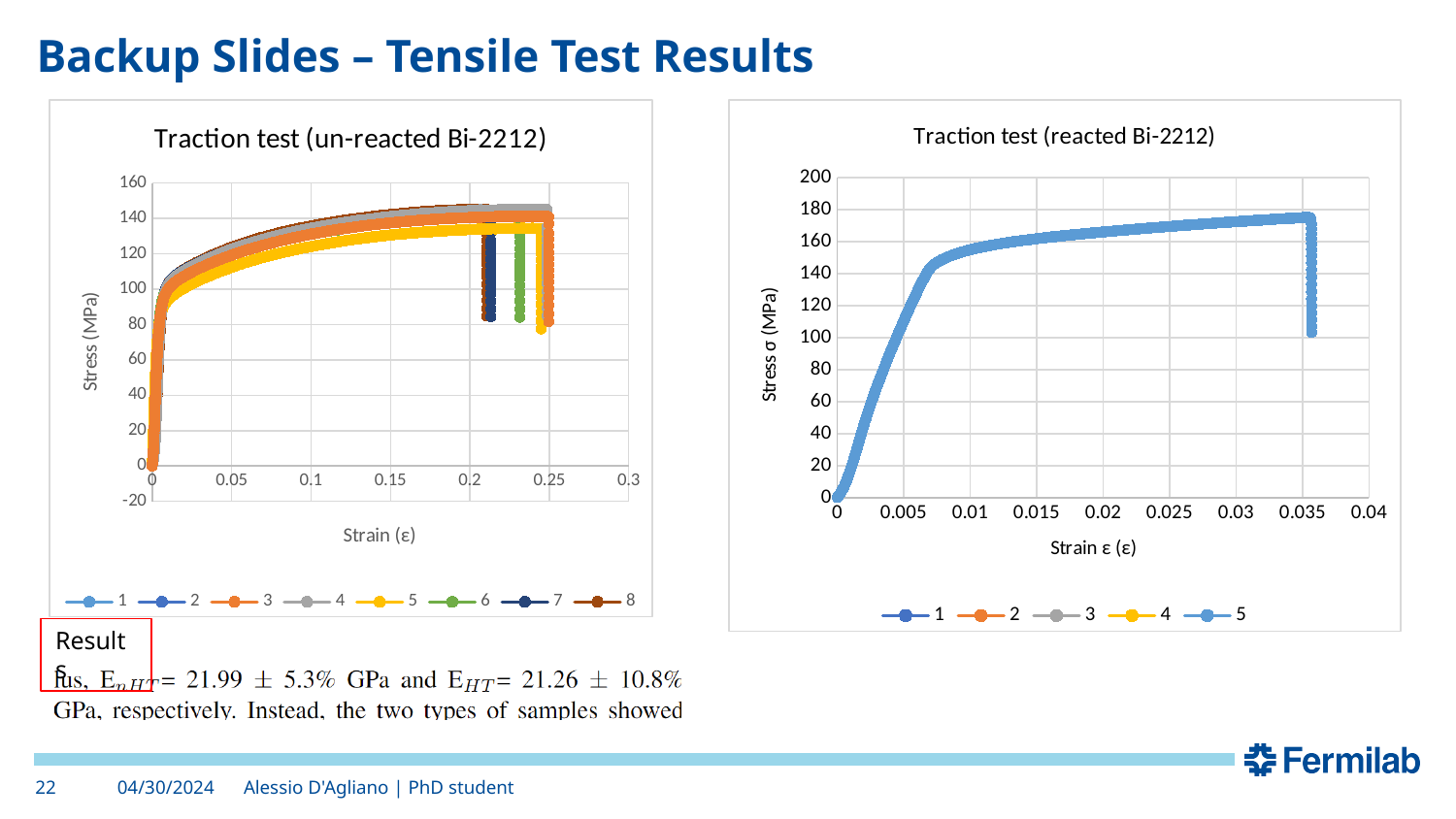
What is the y-axis label of the 'Traction test (reacted Bi-2212)' chart? Stress σ (MPa) In the 'Traction test (un-reacted Bi-2212)' chart, is the maximum stress reached greater or less than 160? less How many series does the legend of the 'Traction test (reacted Bi-2212)' chart list? 5 In the 'Traction test (reacted Bi-2212)' chart, does stress rise or fall as strain increases from 0 to 0.035? rise What is the title of the chart on the left side of the slide? Traction test (un-reacted Bi-2212) In the 'Traction test (reacted Bi-2212)' chart, is the maximum stress reached greater or less than 180? less In the 'Traction test (un-reacted Bi-2212)' chart, is the maximum stress reached greater or less than 120? greater What is the highest value shown on the y-axis of the 'Traction test (reacted Bi-2212)' chart? 200 How many series does the legend of the 'Traction test (un-reacted Bi-2212)' chart list? 8 What kind of chart is the 'Traction test (reacted Bi-2212)' chart? Line chart